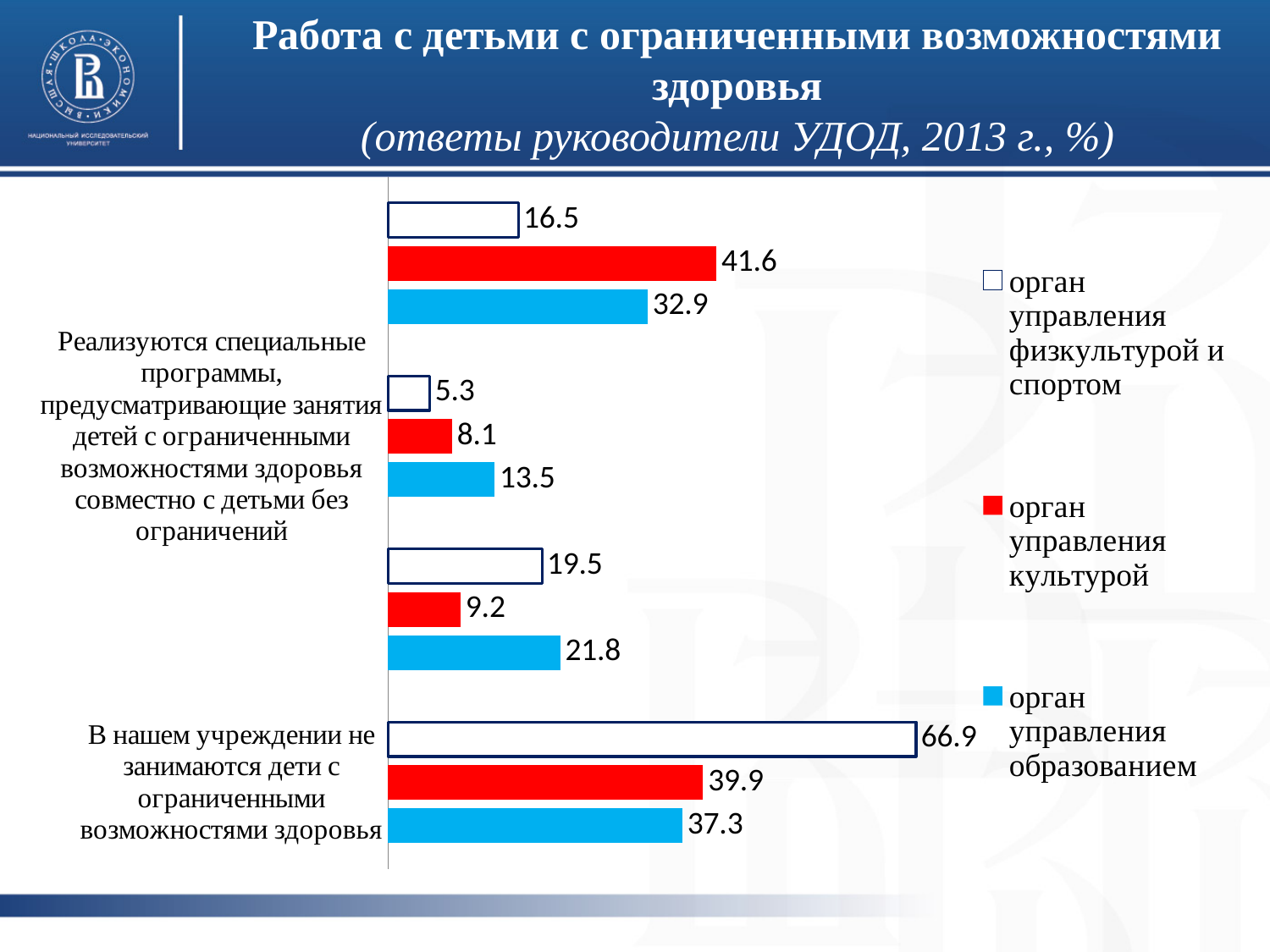
What is the value for орган управления физкультурой и спортом in the category «В нашем учреждении не занимаются дети с ограниченными возможностями здоровья»? 66.9 What kind of chart is shown on the slide? bar chart In the category «В нашем учреждении не занимаются дети с ограниченными возможностями здоровья», which series has the highest value? орган управления физкультурой и спортом What is the value for орган управления образованием in the category «В нашем учреждении не занимаются дети с ограниченными возможностями здоровья»? 37.3 What is the value for орган управления культурой in the category «Реализуются специальные программы, предусматривающие занятия детей с ограниченными возможностями здоровья совместно с детьми без ограничений»? 8.1 How many series does the legend list? 3 In the category «Реализуются специальные программы, предусматривающие занятия детей с ограниченными возможностями здоровья совместно с детьми без ограничений», which series has the lowest value? орган управления физкультурой и спортом What colour represents орган управления культурой in the legend? red What is the value for орган управления образованием in the category «Реализуются специальные программы, предусматривающие занятия детей с ограниченными возможностями здоровья совместно с детьми без ограничений»? 13.5 In the category «В нашем учреждении не занимаются дети с ограниченными возможностями здоровья», what is the difference between the values for орган управления физкультурой и спортом and орган управления культурой? 27.0 In the category «Реализуются специальные программы, предусматривающие занятия детей с ограниченными возможностями здоровья совместно с детьми без ограничений», what is the difference between the values for орган управления образованием and орган управления физкультурой и спортом? 8.2 In the category «Реализуются специальные программы, предусматривающие занятия детей с ограниченными возможностями здоровья совместно с детьми без ограничений», which is larger: the value for орган управления образованием or for орган управления культурой? орган управления образованием